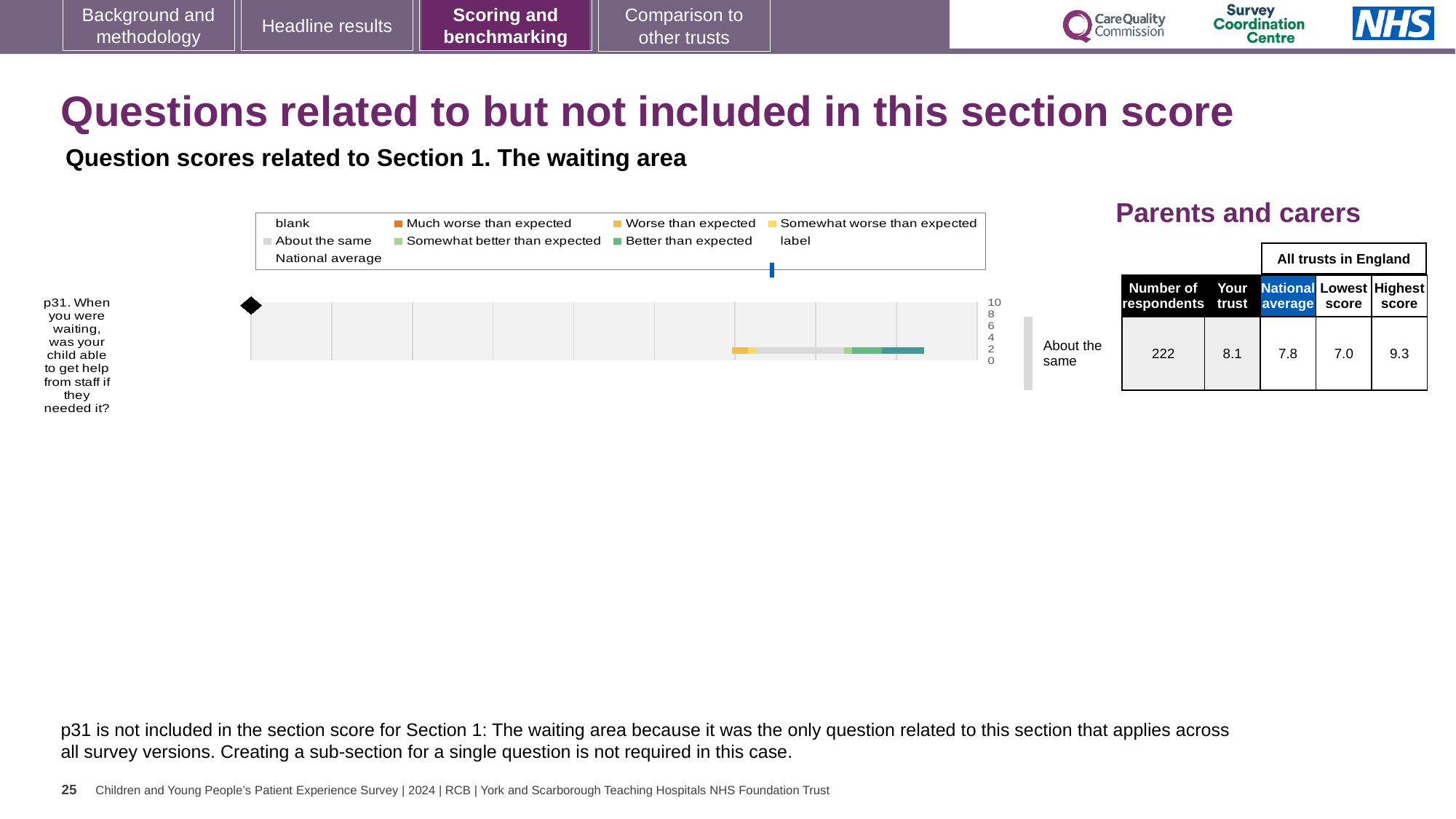
What is the lowest score across all trusts in England for p31? 7.0 What is the national average score for p31 in the Parents and carers table? 7.8 What kind of chart is used to show the p31 question score? bar chart Which question is plotted in the chart? p31. When you were waiting, was your child able to get help from staff if they needed it? For p31, what is the difference between the highest score and the lowest score across all trusts in England? 2.3 For p31, how much higher is the 'Your trust' score than the national average? 0.3 What is the 'Your trust' score for p31 in the Parents and carers table? 8.1 How many respondents answered p31 according to the Parents and carers table? 222 For p31, which is larger: the 'Your trust' score or the national average? Your trust What is the highest score across all trusts in England for p31? 9.3 What rating label is shown to the right of the p31 bar? About the same How many questions are plotted in the chart? 1